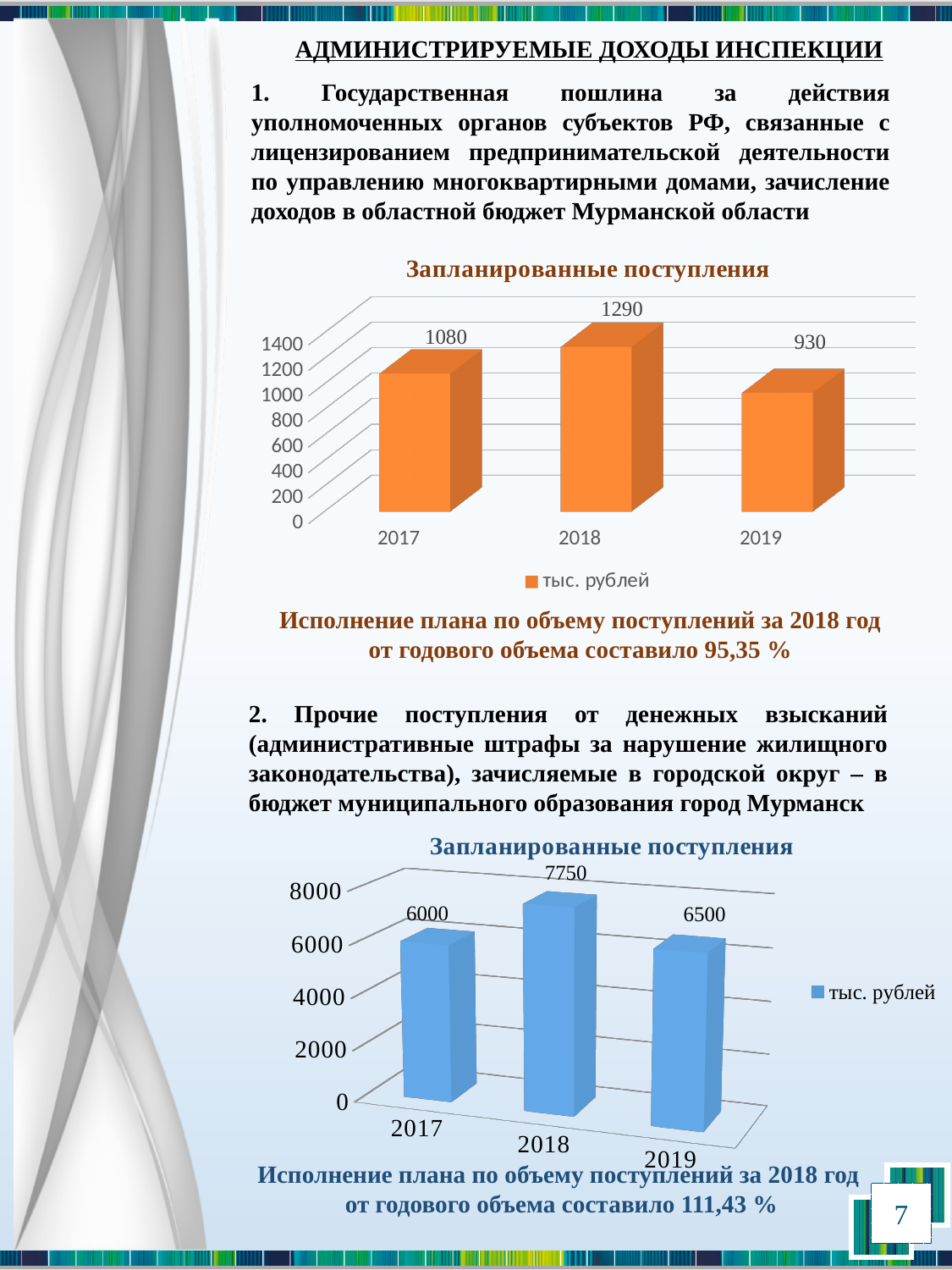
In the bottom chart (blue bars), which year has the lowest value? 2017 In the bottom chart (blue bars), what is the difference between the values for 2018 and 2019? 1250 What kind of chart is the bottom chart (blue bars)? bar chart In the top chart (orange bars), what is the value for 2019? 930 In the top chart (orange bars), which year has the highest value? 2018 In the top chart (orange bars), what is the difference between the values for 2018 and 2017? 210 In the bottom chart (blue bars), which is larger, the value for 2019 or the value for 2017? 2019 In the bottom chart (blue bars), what is the value for 2018? 7750 In the bottom chart (blue bars), what is the value for 2017? 6000 In the top chart (orange bars), which year has the lowest value? 2019 How many categories are shown on the x axis of the top chart (orange bars)? 3 In the top chart (orange bars), what is the value for 2018? 1290